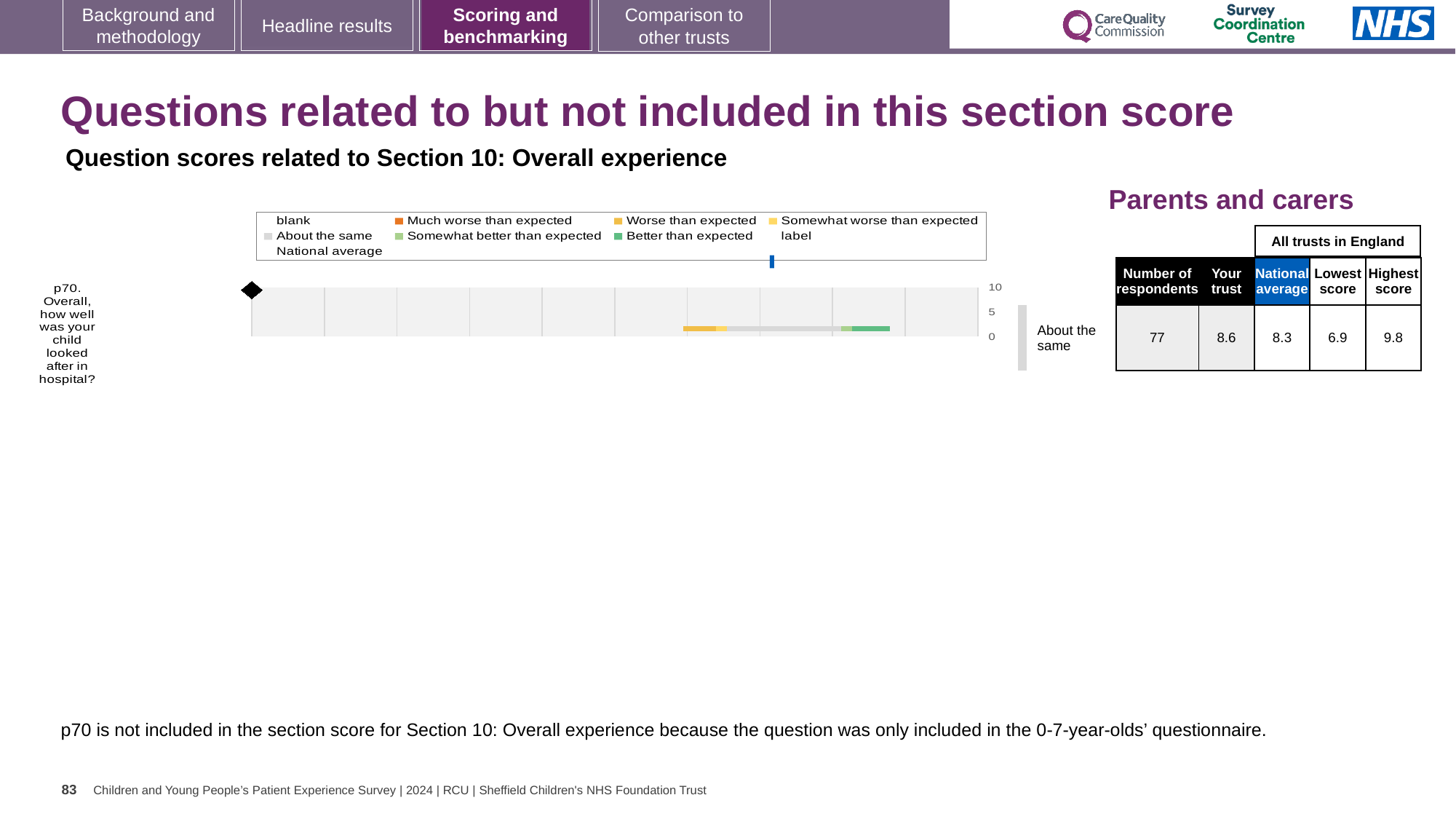
How many respondents answered p70? 77 What is the difference between the 'Your trust' score and the national average for p70? 0.3 What is the national average score for p70? 8.3 Which respondent group does the chart and table refer to? Parents and carers Which is higher for p70: the 'Your trust' score or the national average? Your trust What is the difference between the highest score and the lowest score for p70? 2.9 How many questions are plotted in the chart? 1 What kind of chart is used to show the p70 question score? Bar chart What benchmark category label is shown next to the p70 bar? About the same What is the lowest score among all trusts in England for p70? 6.9 What is the 'Your trust' score for p70 (Overall, how well was your child looked after in hospital?)? 8.6 What is the highest score among all trusts in England for p70? 9.8